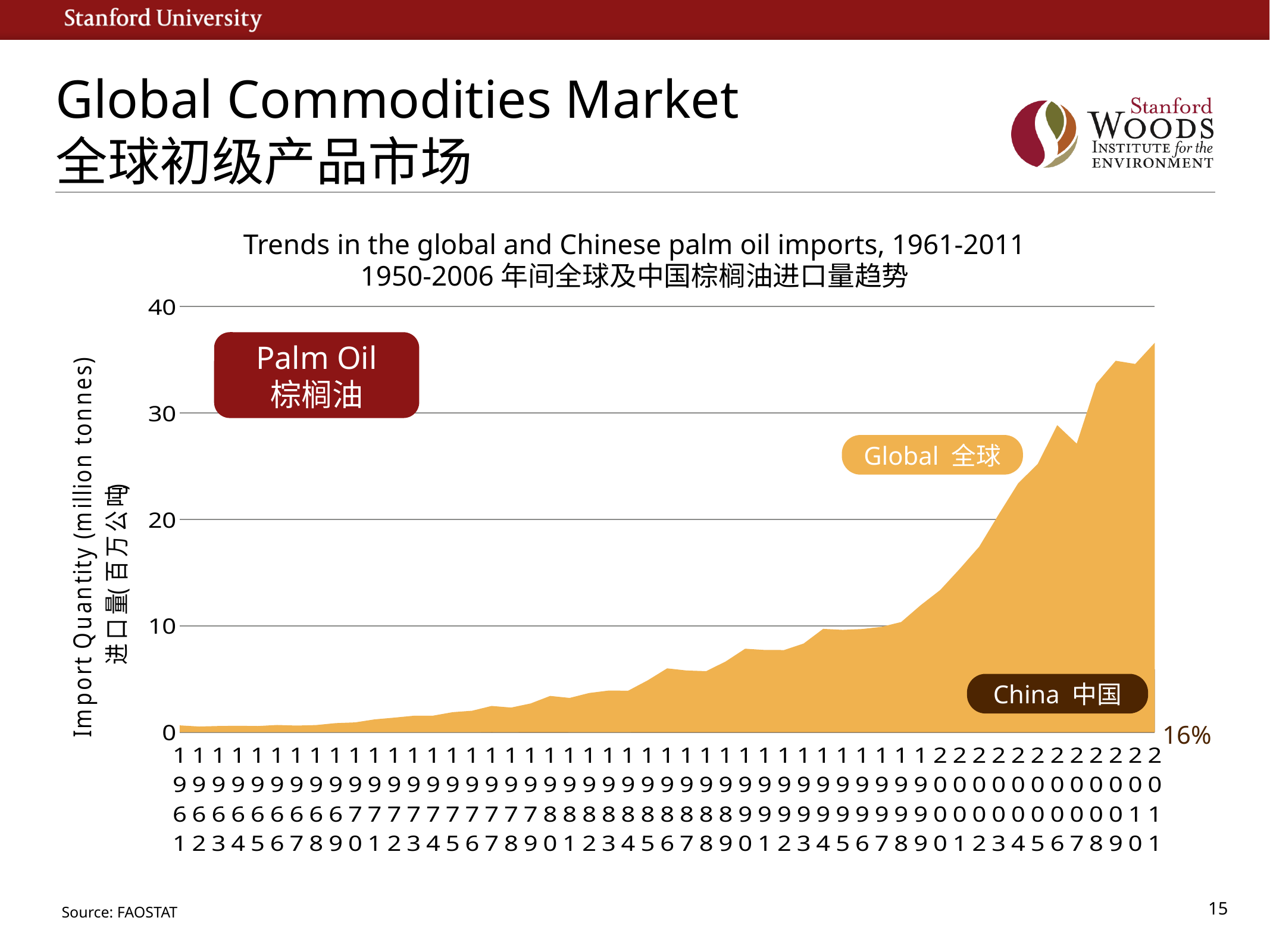
What is the highest value shown on the y-axis? 40 Do global palm oil imports rise or fall from 1961 to 2011? Rise Is the global import value for 1980 greater or less than 10? less Which year has the larger global import value, 2000 or 2010? 2010 Is the global import value for 1990 greater or less than 10? less In which year are global palm oil imports highest? 2011 What is the title of the chart? Trends in the global and Chinese palm oil imports, 1961-2011 Is the global import value for 1961 greater or less than 10? less What is the label of the y-axis? Import Quantity (million tonnes) What kind of chart is shown on the slide? Area chart